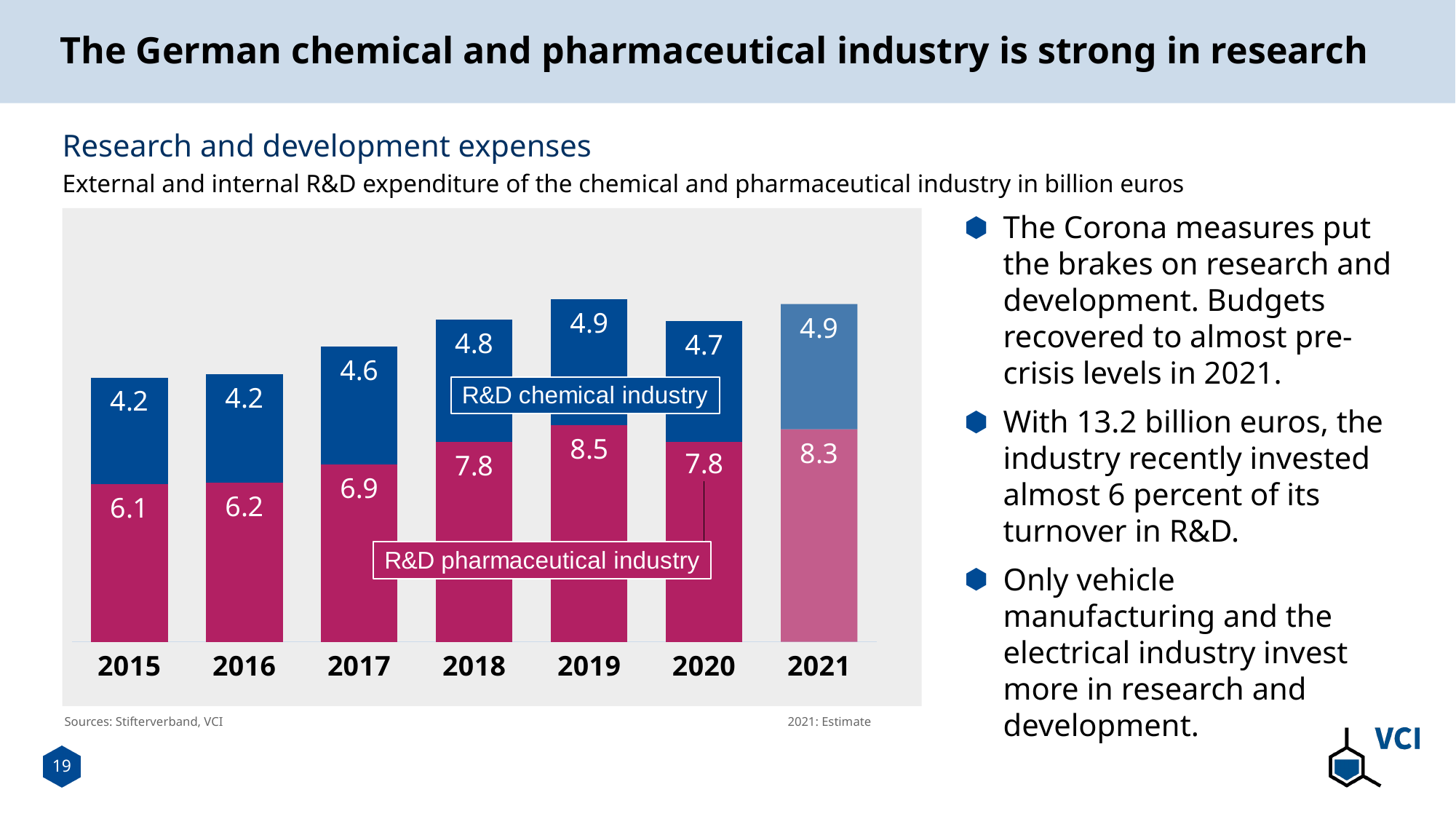
What is the R&D expenditure of the chemical industry in 2017? 4.6 What is the R&D expenditure of the pharmaceutical industry in 2019? 8.5 Which is larger, the chemical industry's R&D expenditure in 2020 or in 2019? 2019 How many series does the chart show? 2 In which year is the R&D expenditure of the pharmaceutical industry highest? 2019 What kind of chart is shown on the slide? Stacked bar chart What is the R&D expenditure of the chemical industry in 2021? 4.9 What is the total R&D expenditure (chemical plus pharmaceutical) in 2018? 12.6 In which year is the R&D expenditure of the pharmaceutical industry lowest? 2015 How many years are shown on the x axis of the chart? 7 Which series is shown in the lower (magenta) segment of each bar? R&D pharmaceutical industry What is the difference between the pharmaceutical industry's R&D expenditure in 2021 and in 2015? 2.2